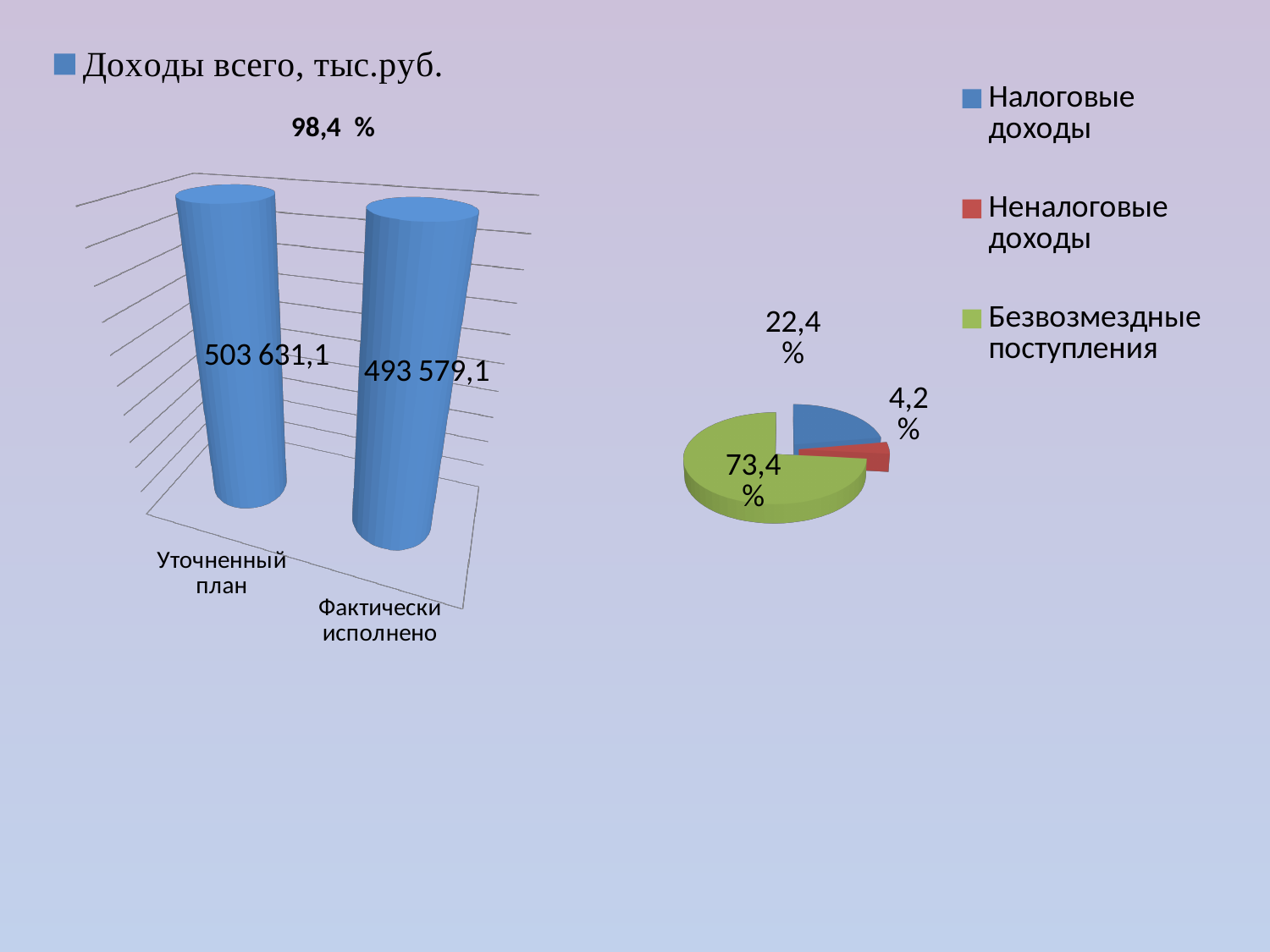
On the right pie chart, what share is Налоговые доходы? 22,4% On the left bar chart, how many bars are plotted? 2 On the right pie chart, what share is Безвозмездные поступления? 73,4% On the right pie chart, which slice is the smallest? Неналоговые доходы On the left bar chart, what is the value for Уточненный план? 503 631,1 On the left bar chart, what is the difference between Уточненный план and Фактически исполнено? 10 052,0 On the left bar chart, which category has the higher value? Уточненный план On the right pie chart, which is larger: Налоговые доходы or Неналоговые доходы? Налоговые доходы On the left chart, what is the legend entry shown above the chart? Доходы всего, тыс.руб. What kind of chart is the chart on the left of the slide? Bar chart On the right pie chart, how many entries does the legend list? 3 On the left bar chart, what is the value for Фактически исполнено? 493 579,1